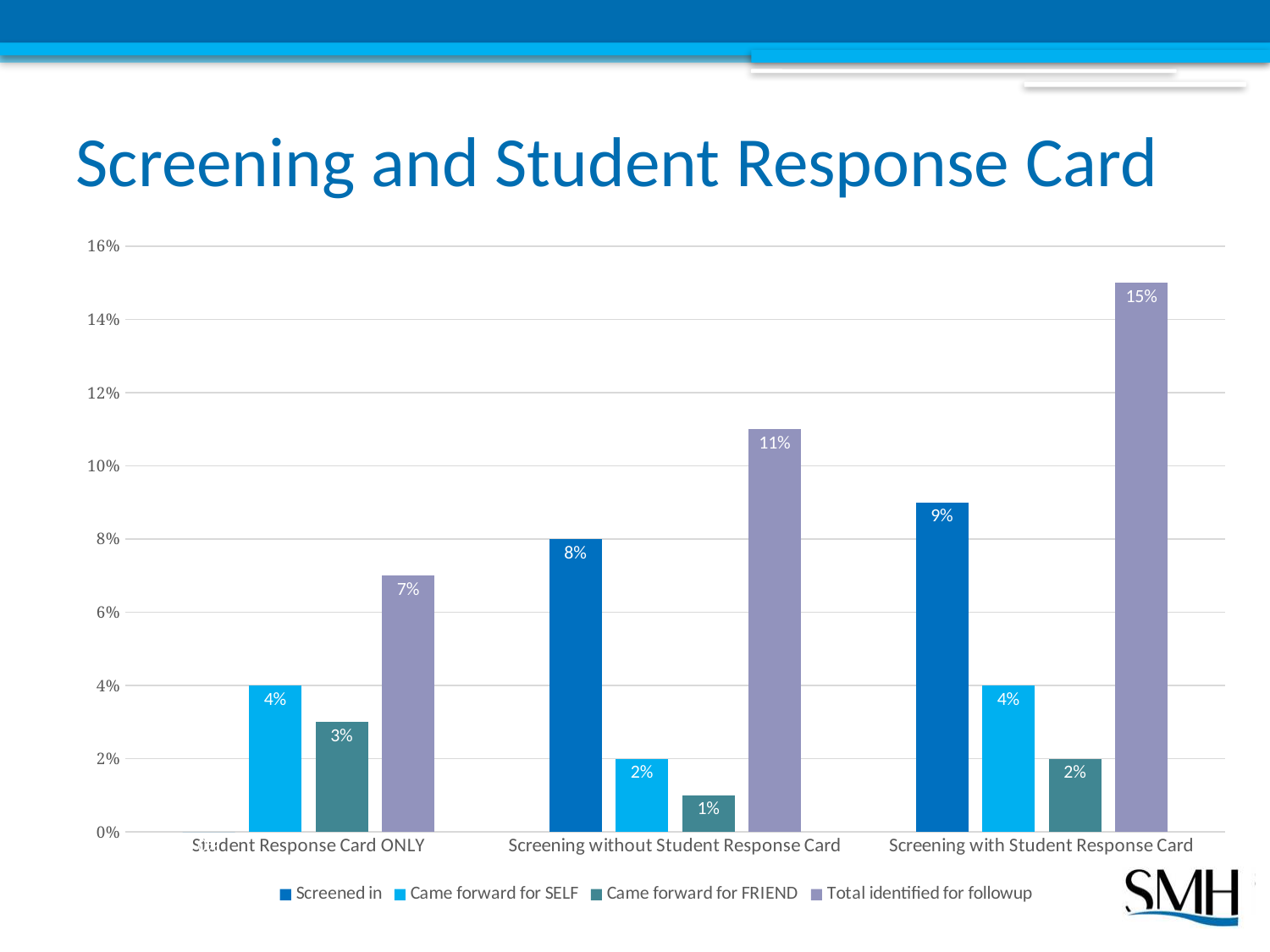
Which category has the lowest Came forward for FRIEND value? Screening without Student Response Card What is the value of Came forward for FRIEND for Student Response Card ONLY? 3% What is the value of Total identified for followup for Screening with Student Response Card? 15% Which is larger: Screened in for Screening with Student Response Card or Screened in for Screening without Student Response Card? Screening with Student Response Card How many series does the legend list? 4 What is the title of the slide? Screening and Student Response Card What kind of chart is shown on the slide? Bar chart What is the difference between Total identified for followup for Screening with Student Response Card and Screening without Student Response Card? 4% What is the value of Came forward for SELF for Screening with Student Response Card? 4% What is the value of Screened in for Screening without Student Response Card? 8% How many categories are shown on the x axis? 3 Which category has the highest Total identified for followup? Screening with Student Response Card